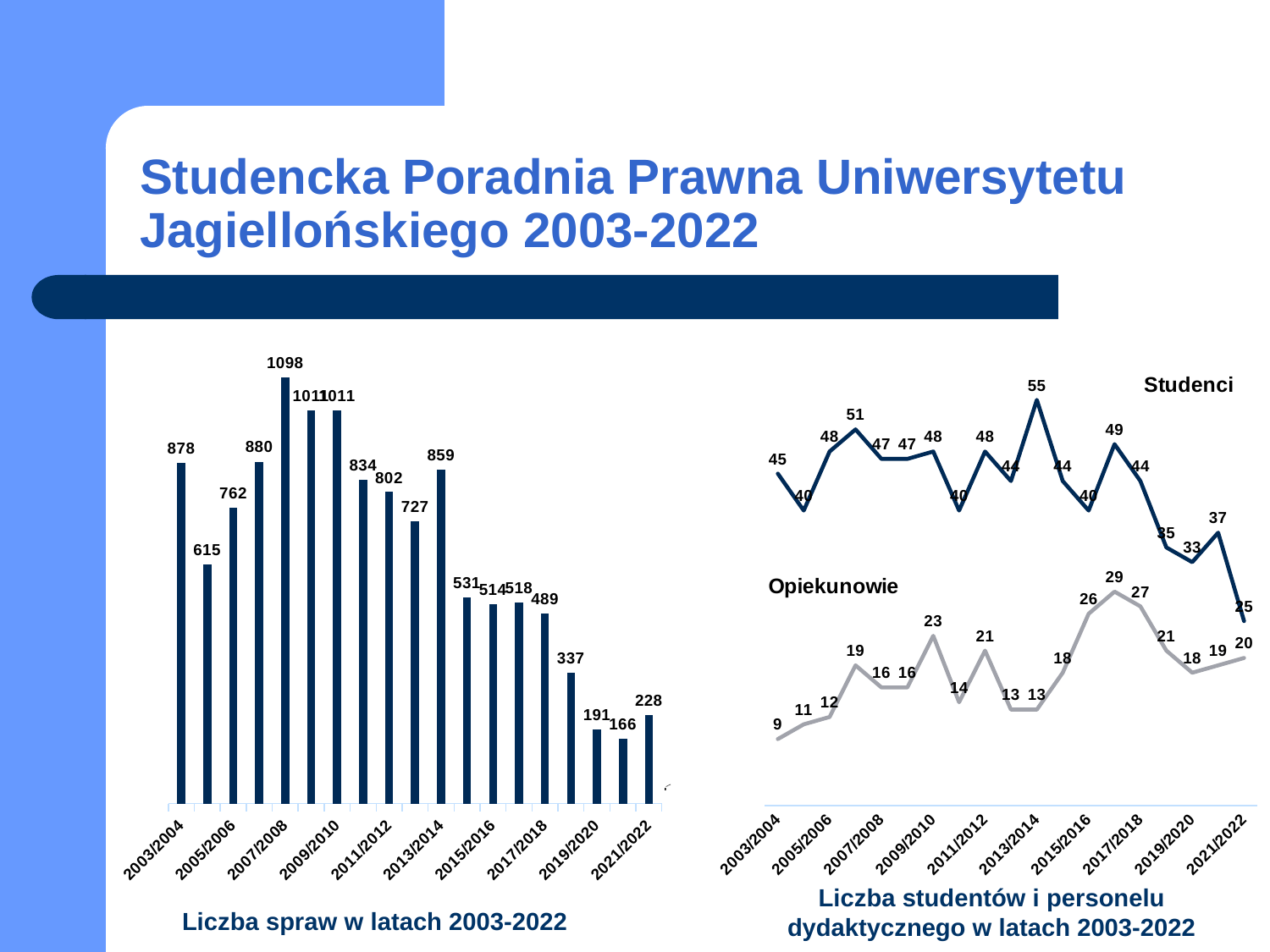
In the chart 'Liczba studentów i personelu dydaktycznego w latach 2003-2022', which series has the higher value in 2021/2022, Studenci or Opiekunowie? Studenci In the chart 'Liczba spraw w latach 2003-2022', do the values generally rise or fall from 2013/2014 to 2021/2022? fall In the chart 'Liczba studentów i personelu dydaktycznego w latach 2003-2022', what is the Opiekunowie value for 2003/2004? 9 How many series are plotted in the chart 'Liczba studentów i personelu dydaktycznego w latach 2003-2022'? 2 What type of chart is 'Liczba spraw w latach 2003-2022'? bar chart In the chart 'Liczba spraw w latach 2003-2022', what is the difference between the values for 2003/2004 and 2021/2022? 650 In the chart 'Liczba studentów i personelu dydaktycznego w latach 2003-2022', what is the difference between Studenci and Opiekunowie in 2021/2022? 5 In the chart 'Liczba spraw w latach 2003-2022', what is the value for 2021/2022? 228 In the chart 'Liczba spraw w latach 2003-2022', which year has the highest number of cases? 2007/2008 In the chart 'Liczba studentów i personelu dydaktycznego w latach 2003-2022', what is the Studenci value for 2013/2014? 55 How many bars are shown in the chart 'Liczba spraw w latach 2003-2022'? 19 In the chart 'Liczba spraw w latach 2003-2022', what is the value for 2007/2008? 1098